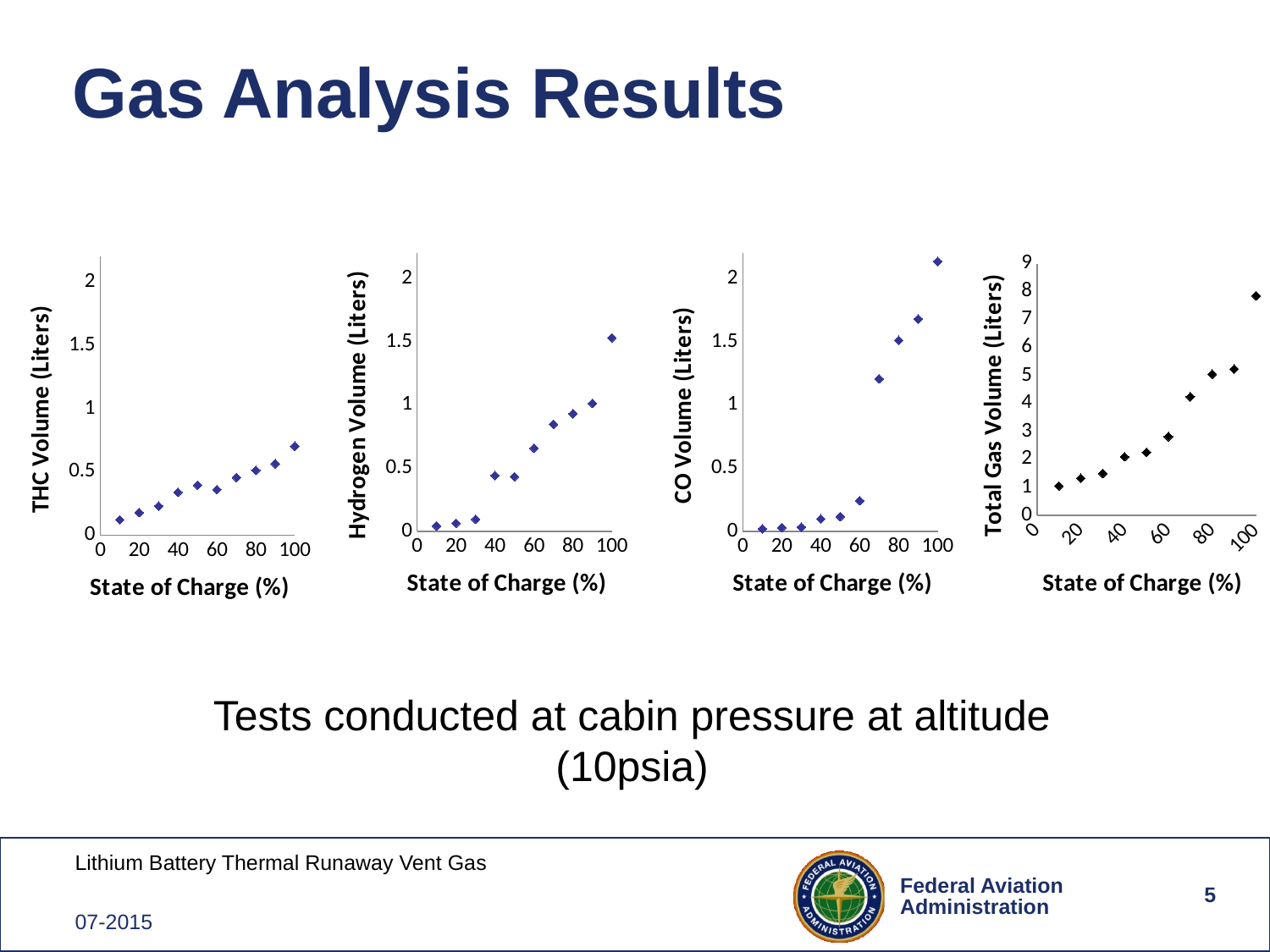
In the CO Volume chart, is the value at 100% State of Charge greater or less than 2? greater In the THC Volume chart, is the value at 100% State of Charge greater or less than 1? less In the CO Volume chart, at which State of Charge is the CO volume highest? 100 At 100% State of Charge, which is larger: the CO volume or the THC volume? CO volume In the Hydrogen Volume chart, do the values rise or fall as State of Charge increases? rise In the Total Gas Volume chart, do the values rise or fall as State of Charge increases? rise In the Total Gas Volume chart, is the value at 100% State of Charge greater or less than 7? greater What kind of chart is the THC Volume chart? scatter chart How many data points are plotted in the CO Volume chart? 10 How many data points are plotted in the Total Gas Volume chart? 10 In the THC Volume chart, at which State of Charge is the THC volume lowest? 10